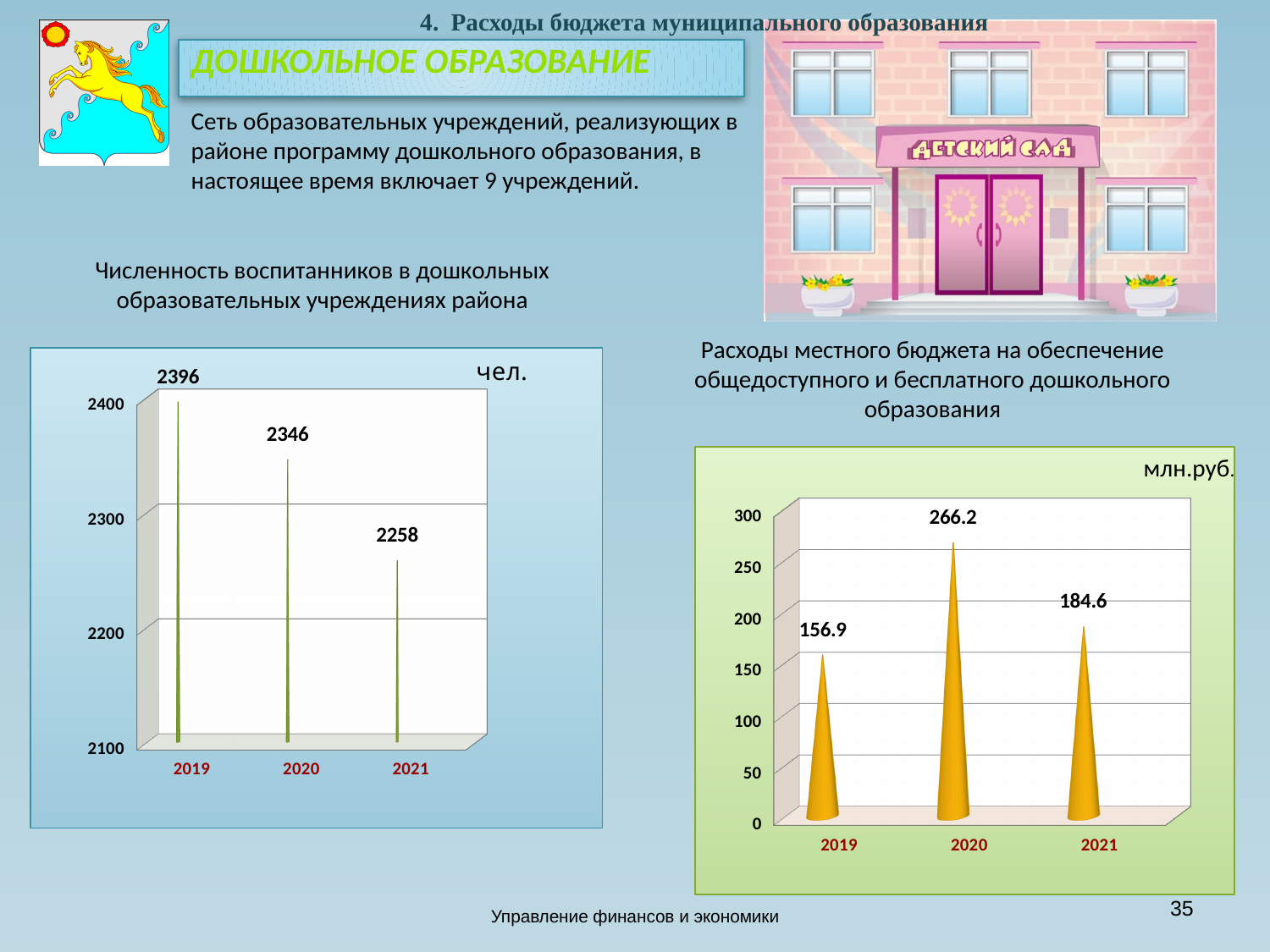
In the right chart (Расходы местного бюджета), what is the difference between the 2020 and 2021 values? 81.6 In the left chart (Численность воспитанников), what is the value for 2021? 2258 In the left chart (Численность воспитанников), how many years are shown on the x axis? 3 In the right chart (Расходы местного бюджета), which is larger: the value for 2019 or the value for 2021? 2021 What unit is shown in the right chart (Расходы местного бюджета)? млн.руб. In the left chart (Численность воспитанников в дошкольных образовательных учреждениях района), what is the value for 2019? 2396 In the right chart (Расходы местного бюджета на обеспечение общедоступного и бесплатного дошкольного образования), what is the value for 2020? 266.2 In the left chart (Численность воспитанников), which year has the lowest value? 2021 In the left chart (Численность воспитанников), do the values rise or fall from 2019 to 2021? fall In the right chart (Расходы местного бюджета), what is the value for 2019? 156.9 In the left chart (Численность воспитанников), what is the difference between the 2019 and 2021 values? 138 In the right chart (Расходы местного бюджета), which year has the highest value? 2020